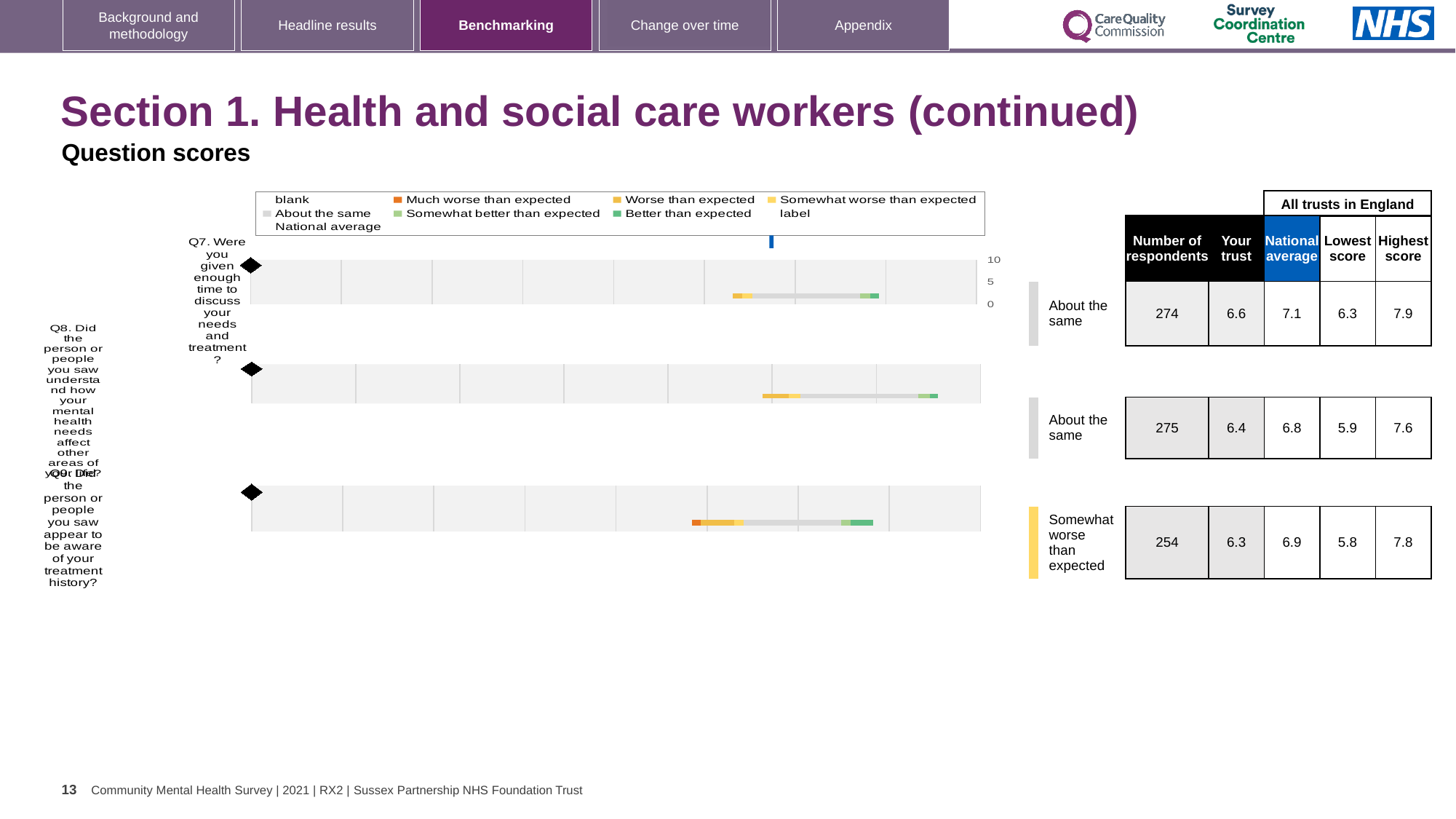
Which question has the lowest number of respondents? Q9 How many questions (Q7, Q8, Q9) are plotted on the slide? 3 Is the 'Your trust' score for Q8 greater or less than 5? greater For Q7, what is the national average score? 7.1 For Q7, which is larger: the 'Your trust' score or the national average? National average For Q8 (Did the person or people you saw understand how your mental health needs affect other areas of your life?), how many respondents were there? 275 What benchmark category is shown for Q9? Somewhat worse than expected What kind of chart is used to show the question scores on this slide? bar chart Which question has the highest 'Your trust' score? Q7 For Q9 (Did the person or people you saw appear to be aware of your treatment history?), what is the highest score among all trusts in England? 7.8 For Q7 (Were you given enough time to discuss your needs and treatment?), what is the 'Your trust' score? 6.6 For Q9, what is the difference between the highest score and the lowest score? 2.0